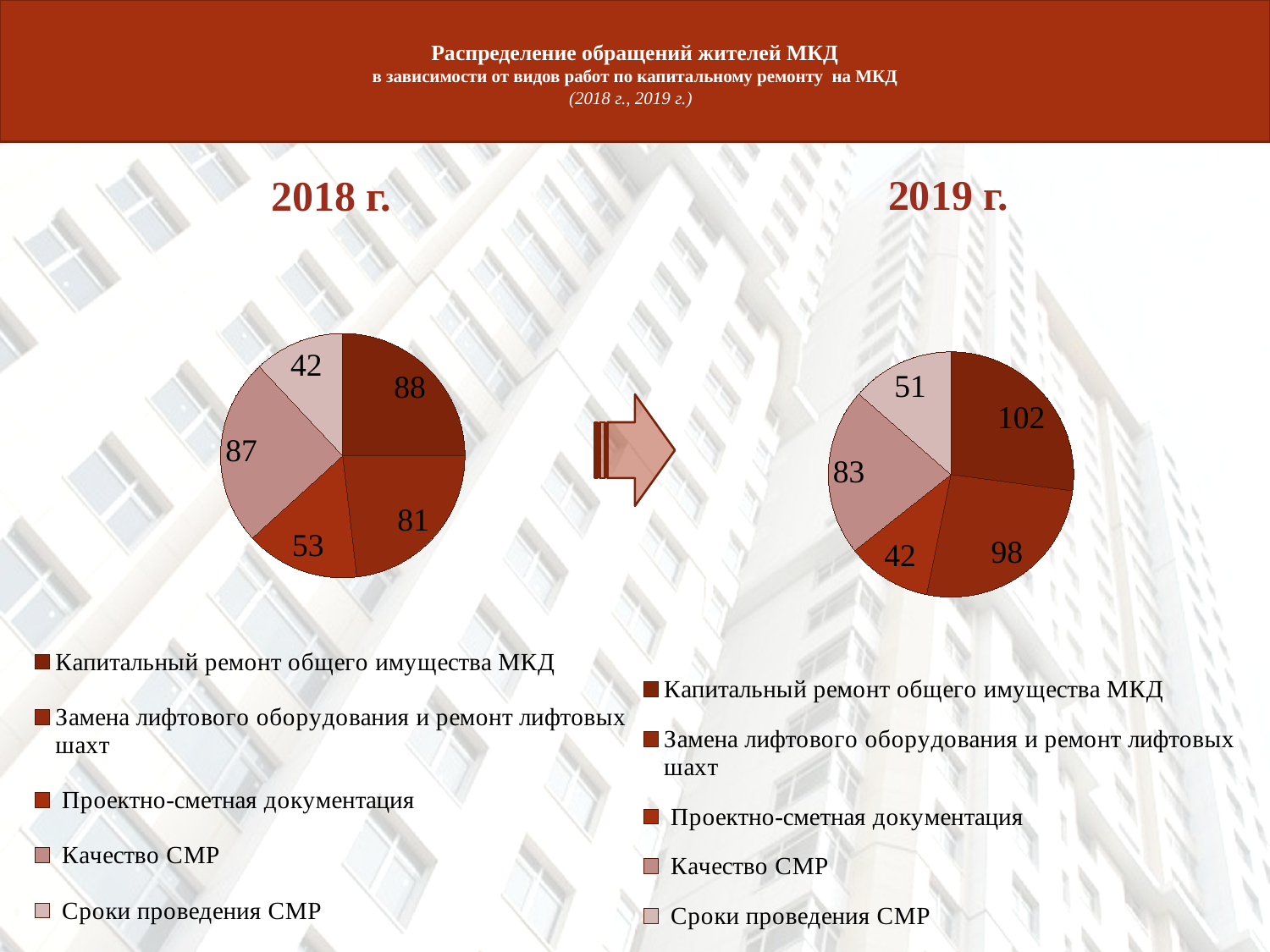
In the 2018 г. pie chart, what is the value for Сроки проведения СМР? 42 What type of chart is used for the 2018 г. data? pie chart In the 2019 г. pie chart, which category has the smallest value? Проектно-сметная документация What is the total of all values in the 2018 г. pie chart? 351 How many categories does the 2019 г. pie chart show? 5 In the 2019 г. pie chart, which category has the largest value? Капитальный ремонт общего имущества МКД In the 2018 г. pie chart, what is the value for Капитальный ремонт общего имущества МКД? 88 What is the difference between the 2019 г. and 2018 г. values for Капитальный ремонт общего имущества МКД? 14 In the 2018 г. pie chart, which is larger: Качество СМР or Замена лифтового оборудования и ремонт лифтовых шахт? Качество СМР In the 2019 г. pie chart, what is the value for Замена лифтового оборудования и ремонт лифтовых шахт? 98 What is the total of all values in the 2019 г. pie chart? 376 In the 2018 г. pie chart, which category has the smallest value? Сроки проведения СМР